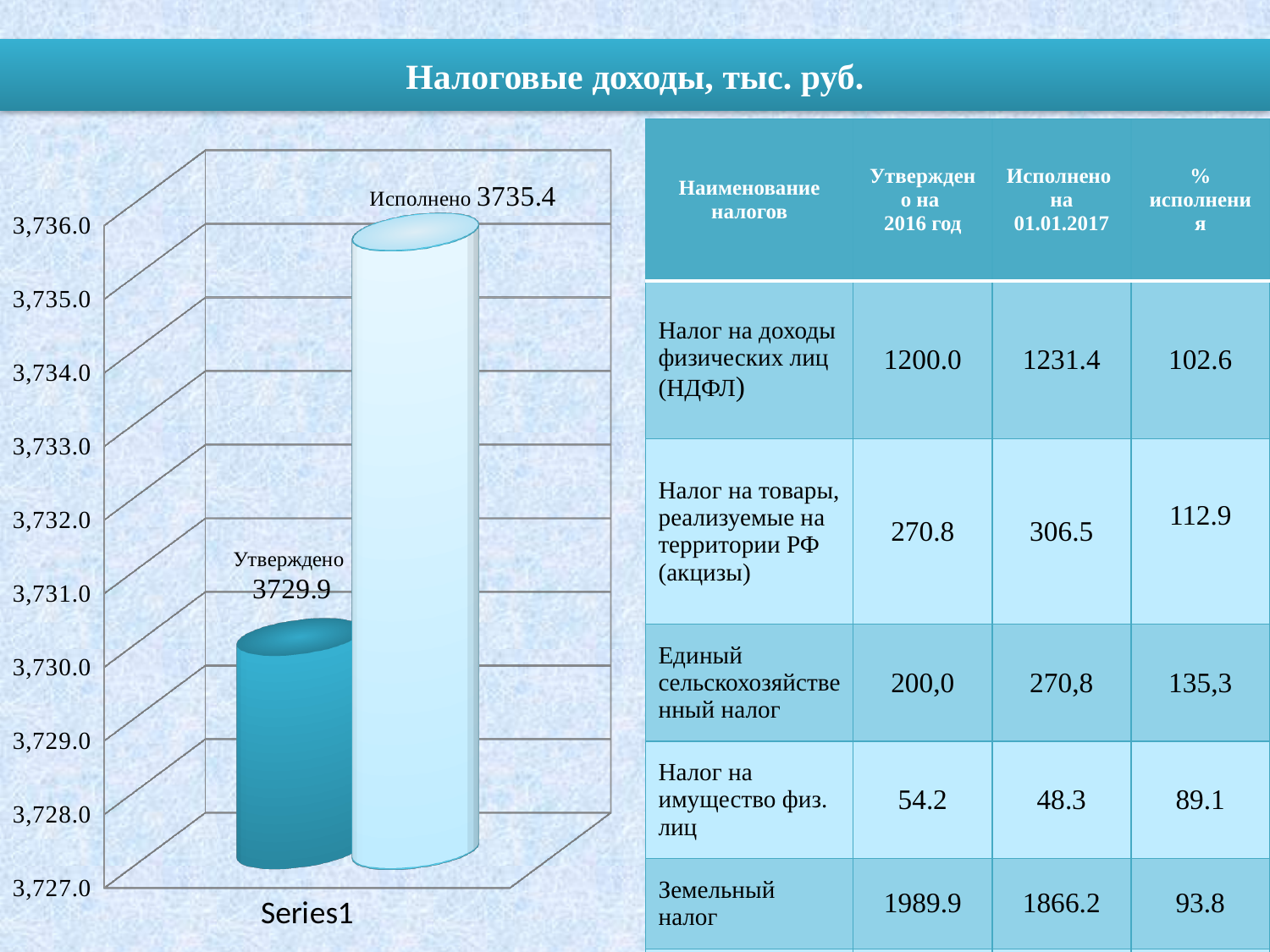
How many bars are plotted in the chart? 2 Which bar in the chart is higher, Утверждено or Исполнено? Исполнено What kind of chart is shown on the slide? bar chart What label appears under the bars on the horizontal axis of the chart? Series1 What is the value of the Исполнено bar in the chart? 3735.4 What is the title of the slide containing the chart? Налоговые доходы, тыс. руб. Which bar in the chart has the lowest value? Утверждено What is the value of the Утверждено bar in the chart? 3729.9 Is the value for Утверждено greater or less than 3,732.0? less What is the difference between the Исполнено and Утверждено values in the chart? 5.5 Is the Утверждено value larger or smaller than the Исполнено value in the chart? smaller Is the value for Исполнено greater or less than 3,733.0? greater